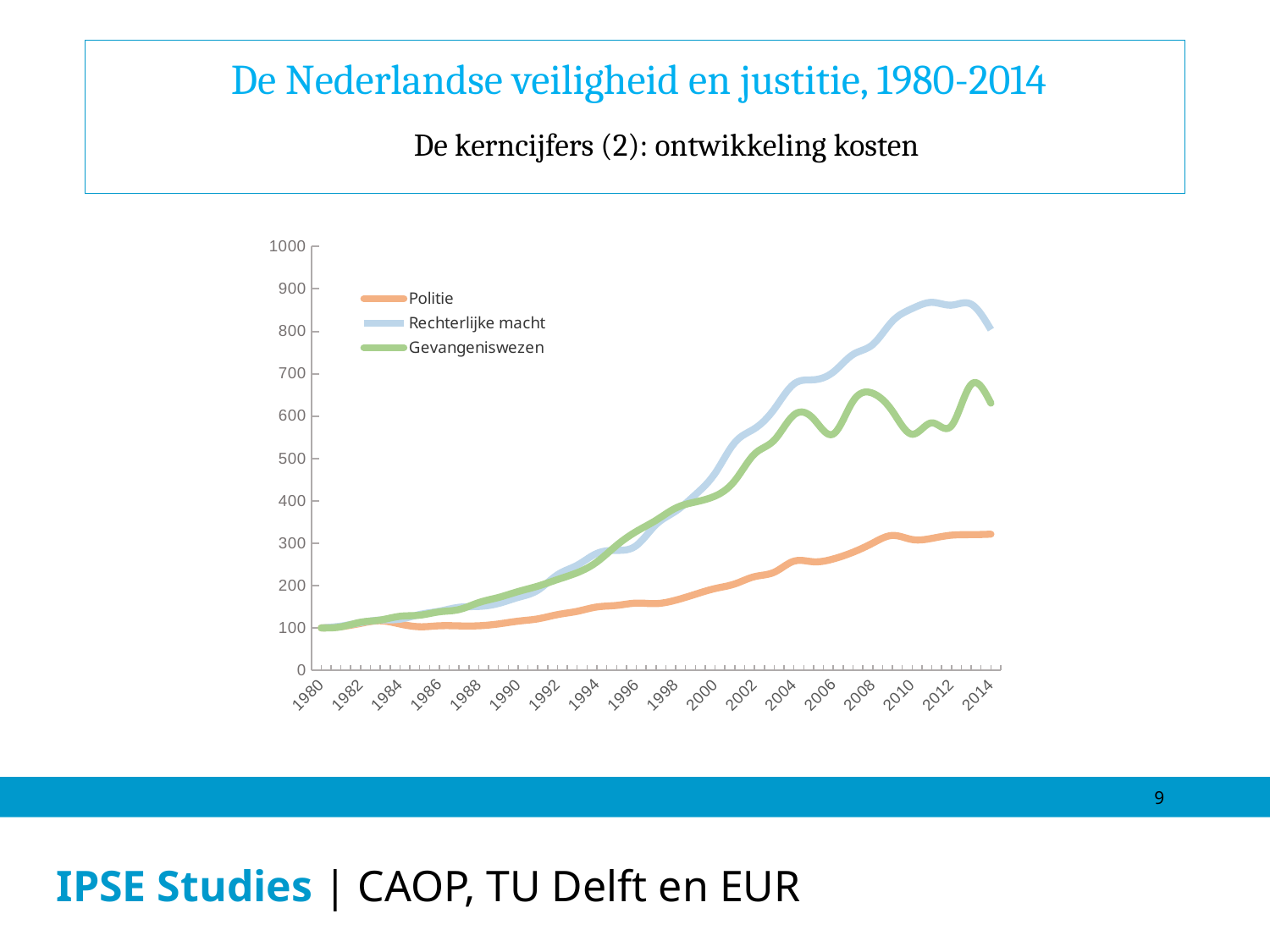
Is the value for Politie in 2014 greater or less than 400? less Does the Politie series rise or fall overall from 1980 to 2014? rise What colour is the Politie line in the legend? orange What is the value of all three series in 1980? 100 Is the value for Politie in 2000 greater or less than 300? less In 2014, which is larger: Gevangeniswezen or Politie? Gevangeniswezen How many series does the legend list? 3 Is the value for Gevangeniswezen in 2014 greater or less than 600? greater Which series is lowest in 2014? Politie What kind of chart is shown on the slide? line chart Which series is highest in 2014? Rechterlijke macht